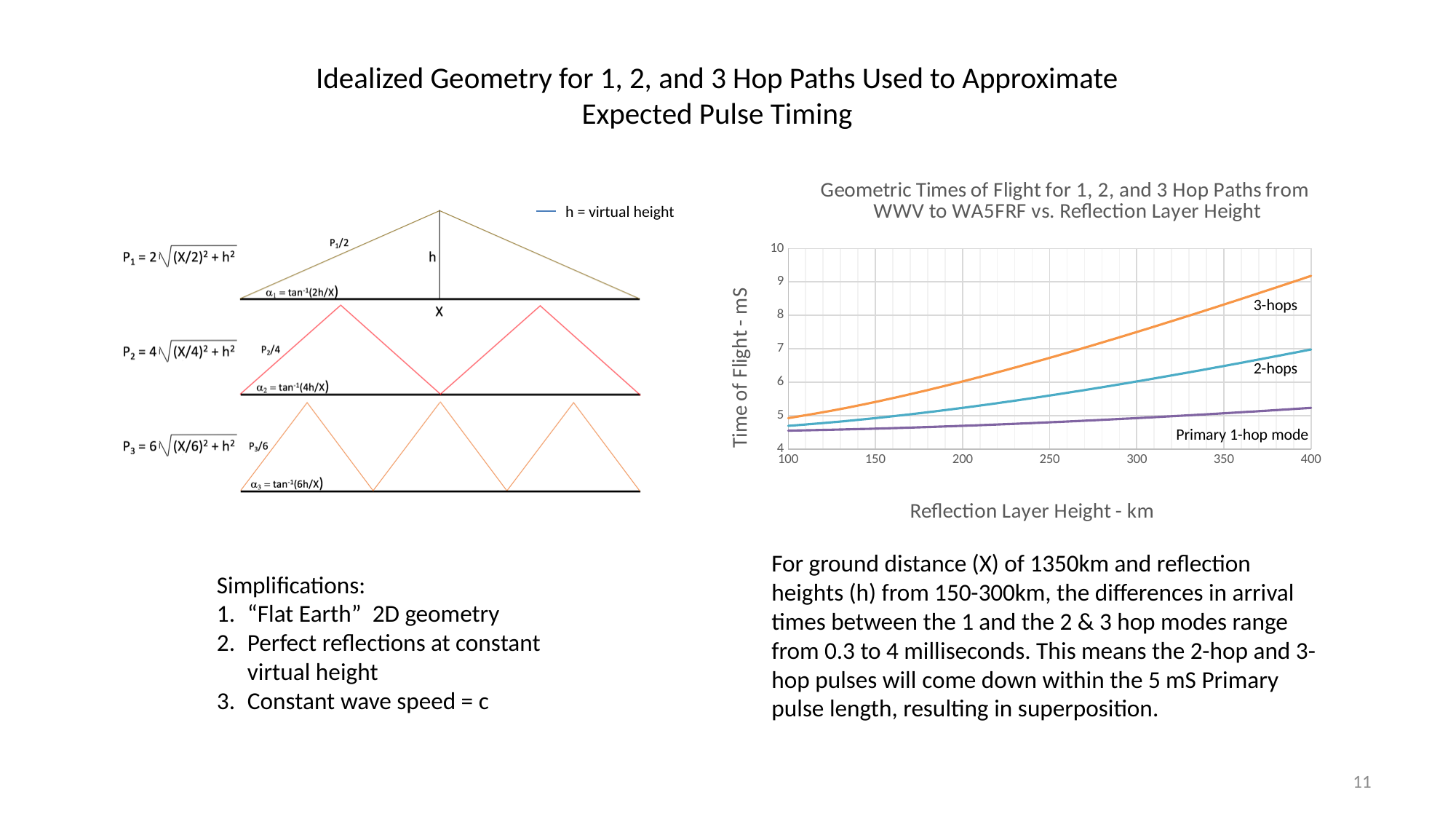
Which series has the highest time of flight at a reflection layer height of 400 km? 3-hops What kind of chart is shown on the slide? line chart At 400 km, is the time of flight for 3-hops greater or less than 8? greater Which series has the lowest time of flight across the plotted range? Primary 1-hop mode Does the time of flight for the 3-hops path rise or fall as reflection layer height increases? rise What is the label of the x axis of the chart? Reflection Layer Height - km At 100 km, is the time of flight for the Primary 1-hop mode greater or less than 5? less At 300 km, is the time of flight for 3-hops greater or less than 7? greater What is the title of the chart? Geometric Times of Flight for 1, 2, and 3 Hop Paths from WWV to WA5FRF vs. Reflection Layer Height How many series (lines) are plotted in the chart? 3 At 400 km, which has the larger time of flight, 3-hops or 2-hops? 3-hops